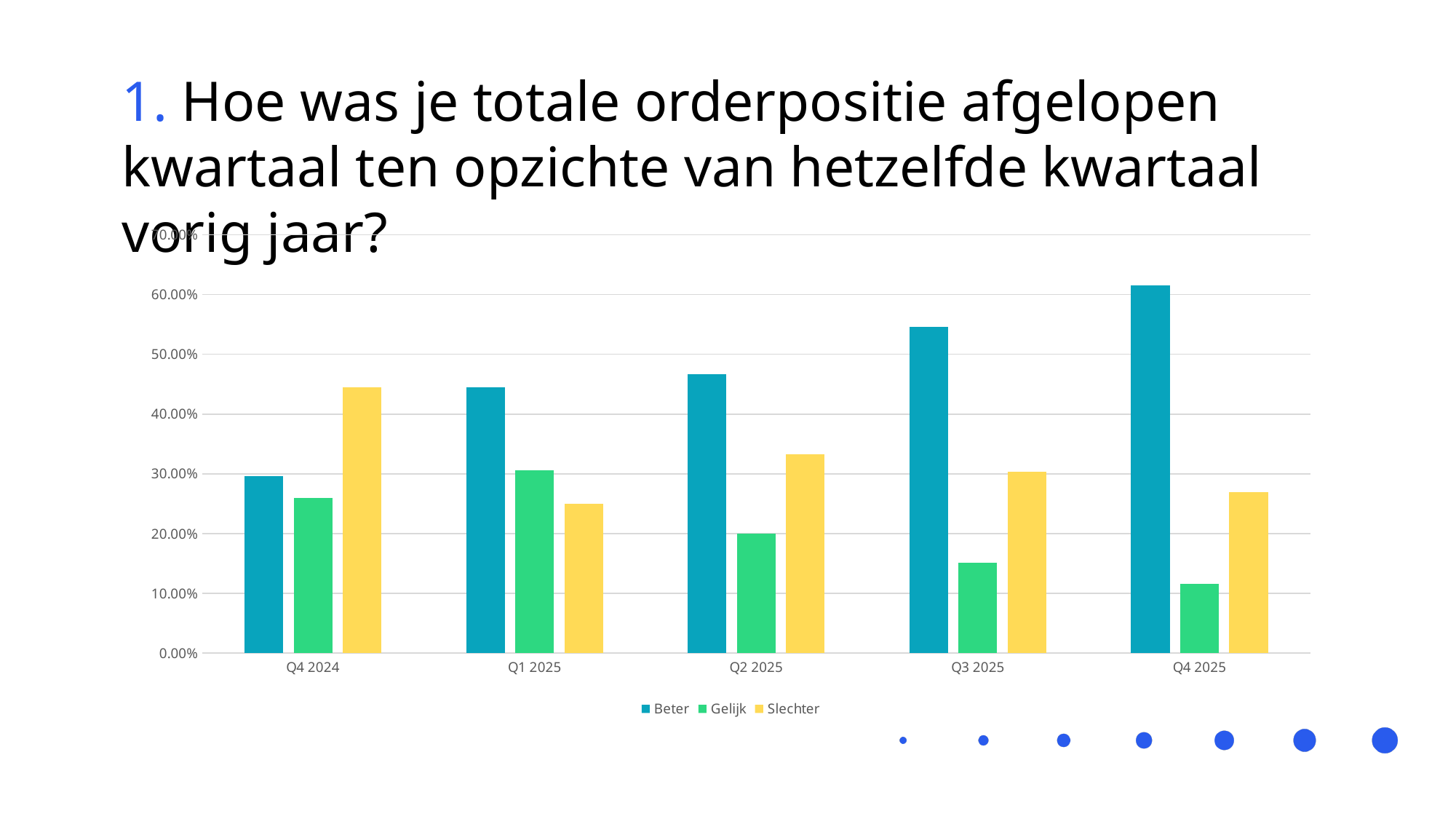
In which quarter is the Slechter value highest? Q4 2024 In which quarter is the Gelijk value lowest? Q4 2025 In which quarter is the Beter value highest? Q4 2025 In Q4 2024, which is larger: Beter or Slechter? Slechter Does the Beter series rise or fall from Q4 2024 to Q4 2025? Rises How many series does the legend list? 3 Is the Slechter value for Q4 2024 greater or less than 40.00%? greater What kind of chart is shown on the slide? Bar chart Is the Gelijk value for Q3 2025 greater or less than 20.00%? less Is the Beter value for Q4 2025 greater or less than 50.00%? greater In Q2 2025, which is larger: Gelijk or Slechter? Slechter How many quarters are shown on the x axis? 5